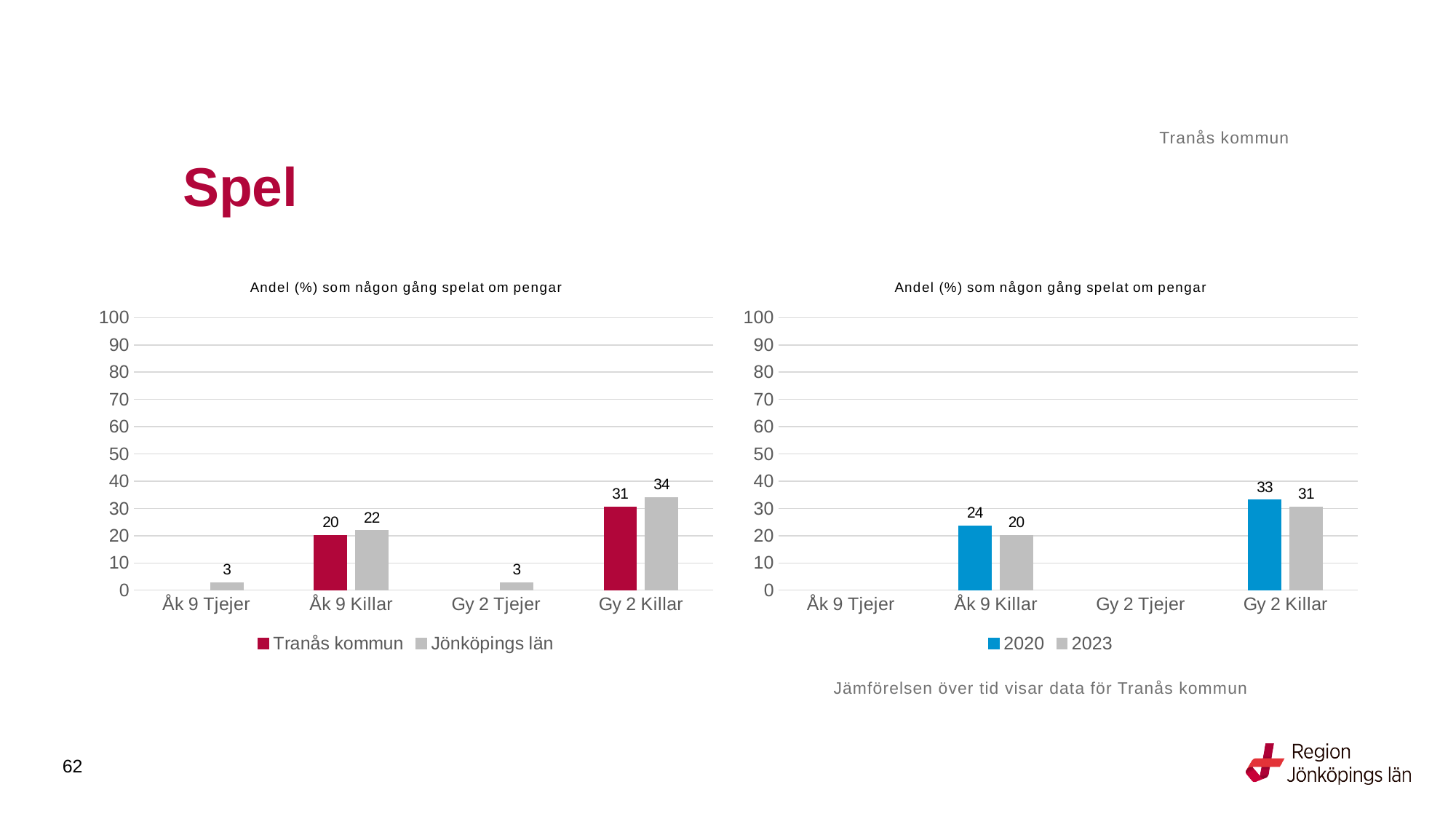
In the right chart, which is larger for Gy 2 Killar: 2020 or 2023? 2020 In the right chart, what is the value for 2023 for Gy 2 Killar? 31 What type of chart is the right chart? Bar chart In the left chart, what is the difference between Jönköpings län and Tranås kommun for Gy 2 Killar? 3 How many categories are shown on the x axis of the right chart? 4 In the right chart, what is the difference between 2020 and 2023 for Åk 9 Killar? 4 In the left chart, what is the value for Jönköpings län for Gy 2 Killar? 34 In the right chart, what is the value for 2020 for Åk 9 Killar? 24 In the left chart, which is larger for Åk 9 Killar: Tranås kommun or Jönköpings län? Jönköpings län In the left chart, what is the value for Tranås kommun for Åk 9 Killar? 20 In the left chart, what is the value for Jönköpings län for Åk 9 Tjejer? 3 In the left chart, how many series does the legend list? 2